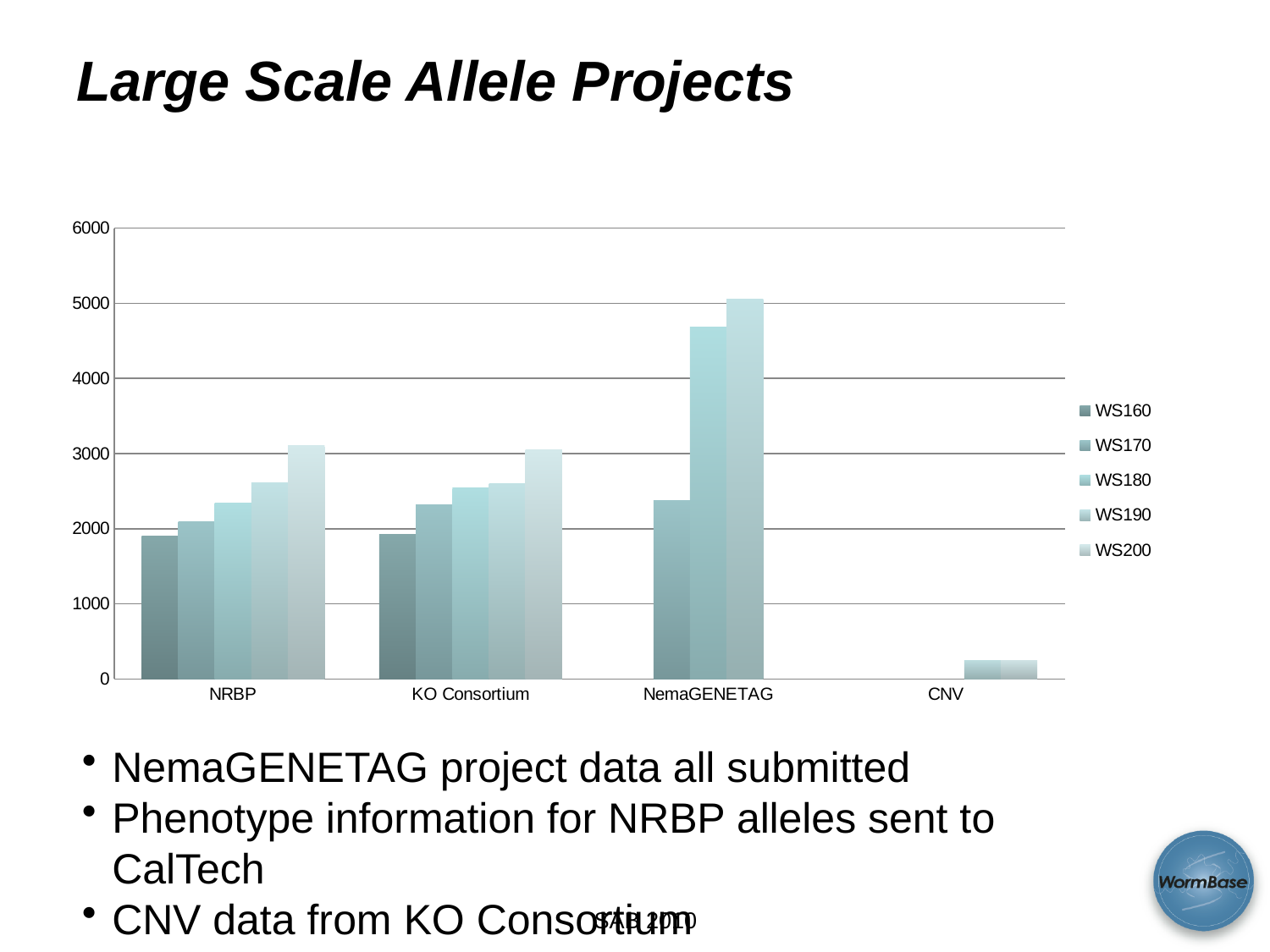
What kind of chart is shown on the slide? bar chart What is the first series listed in the legend? WS160 Is the WS190 value for NemaGENETAG greater or less than 4000? greater How many series does the legend list? 5 For NRBP, do the values rise or fall from WS160 to WS200? rise Which category has the lowest values in the chart? CNV Which category contains the tallest bar in the chart? NemaGENETAG Which is larger, the WS180 value for NemaGENETAG or the WS180 value for NRBP? NemaGENETAG Is the WS160 value for NRBP greater or less than 2000? less How many categories are shown on the x axis? 4 Is the WS200 value for NRBP greater or less than 3000? greater